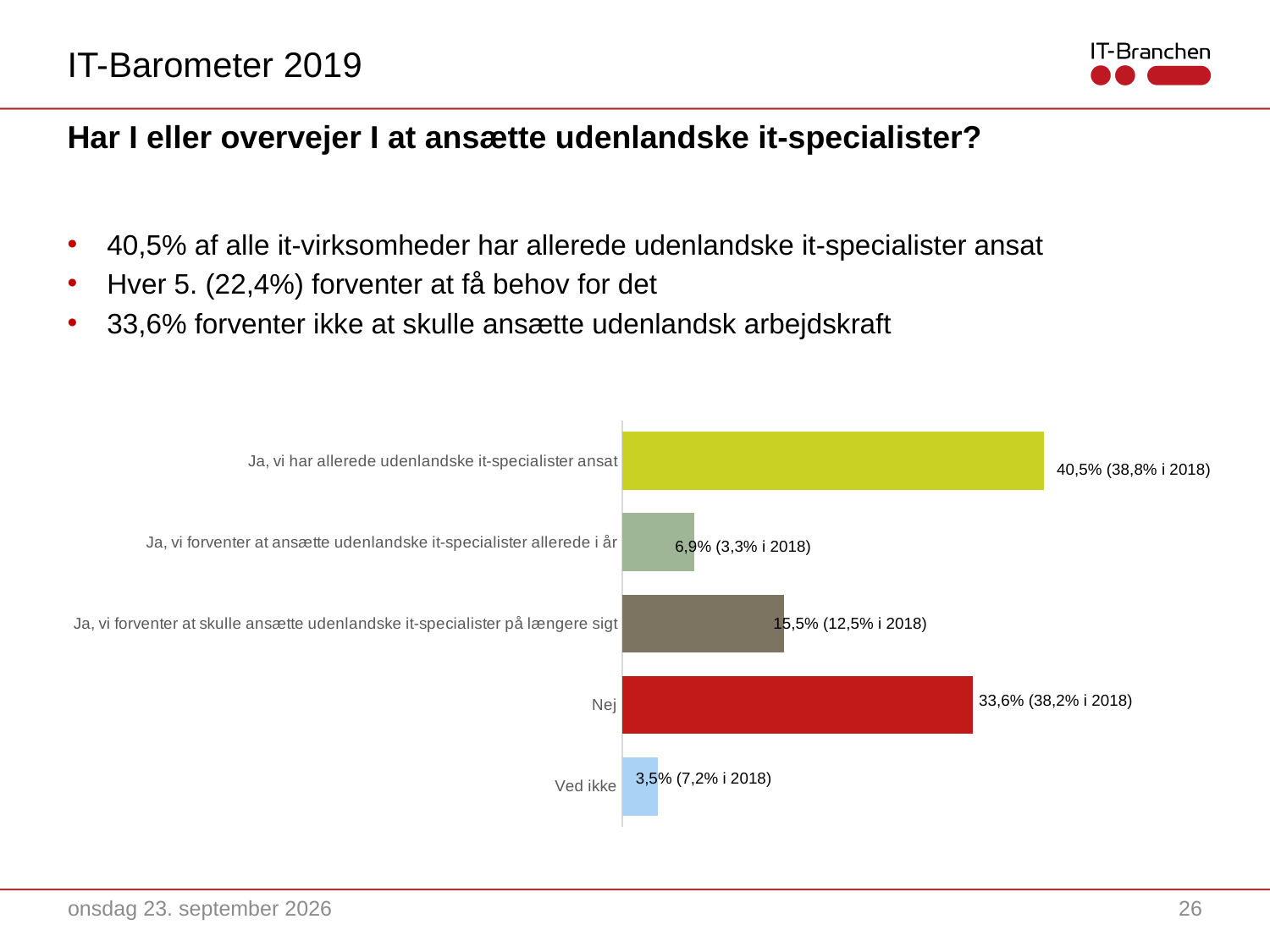
What is the value for "Ja, vi forventer at skulle ansætte udenlandske it-specialister på længere sigt"? 15,5% What is the difference between the 2019 and 2018 values for "Ja, vi forventer at ansætte udenlandske it-specialister allerede i år"? 3,6% What is the difference between the values for "Ja, vi har allerede udenlandske it-specialister ansat" and "Nej"? 6,9% What was the 2018 value shown for "Ja, vi har allerede udenlandske it-specialister ansat"? 38,8% Which category has the lowest value? Ved ikke Which category has the highest value? Ja, vi har allerede udenlandske it-specialister ansat What kind of chart is shown on the slide? Bar chart Which is larger: the value for "Ja, vi forventer at ansætte udenlandske it-specialister allerede i år" or for "Ja, vi forventer at skulle ansætte udenlandske it-specialister på længere sigt"? Ja, vi forventer at skulle ansætte udenlandske it-specialister på længere sigt How many categories are shown in the chart? 5 What is the value for "Ved ikke"? 3,5% What is the value for "Nej"? 33,6% What colour is the bar for "Nej"? Red